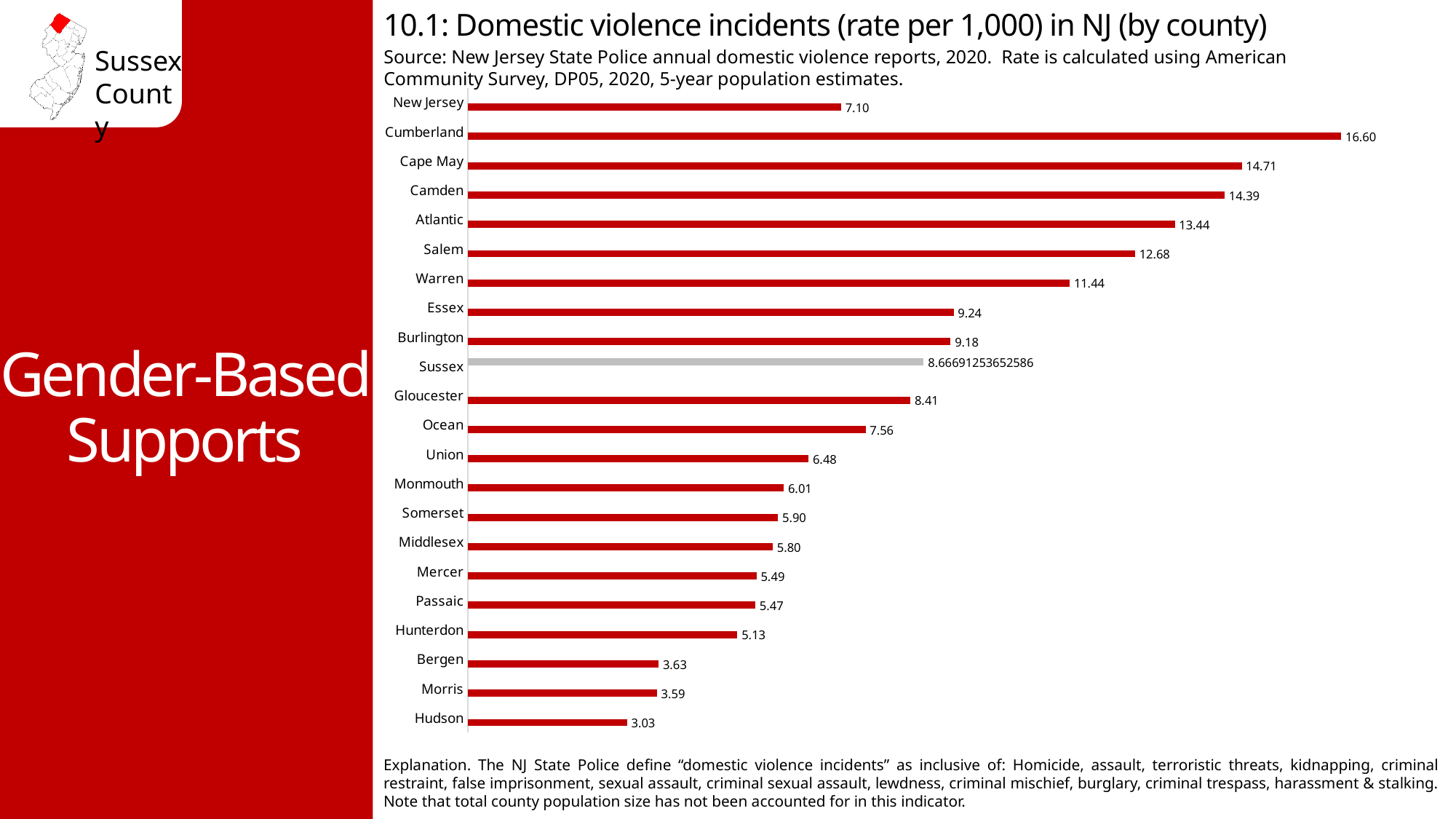
Which has a higher rate, Ocean or Hunterdon? Ocean How many bars (categories) are shown in the chart? 22 Which county has the highest domestic violence incident rate? Cumberland What is the difference between the rates for Warren and Salem? 1.24 What type of chart is shown on the slide? Bar chart Which county has the lowest domestic violence incident rate? Hudson What is the rate shown for New Jersey? 7.10 What value is printed on the Sussex bar? 8.66691253652586 Which has a higher rate, Atlantic or Gloucester? Atlantic What is the domestic violence incident rate for Cumberland? 16.60 What value is shown for Warren? 11.44 What is the difference between the rates for Cumberland and Cape May? 1.89